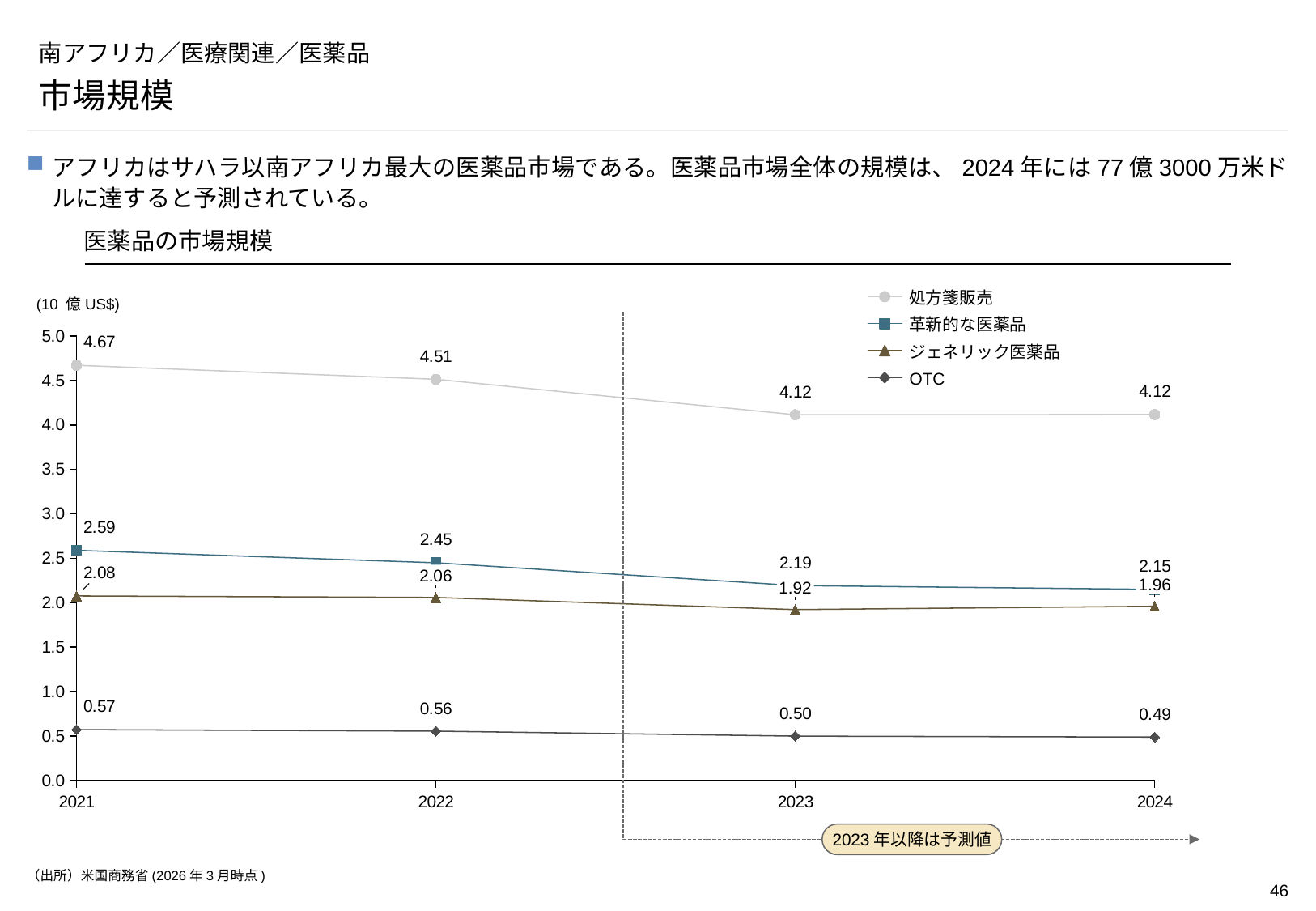
Which is larger in 2023: 革新的な医薬品 or ジェネリック医薬品? 革新的な医薬品 What is the value for 処方箋販売 in 2021? 4.67 What is the value for ジェネリック医薬品 in 2022? 2.06 How many series does the legend list? 4 Does the OTC series rise or fall from 2021 to 2024? Fall What is the value for OTC in 2024? 0.49 Which series has the highest value in 2024? 処方箋販売 What is the difference between the 処方箋販売 values for 2021 and 2024? 0.55 How many years are shown on the x axis? 4 What type of chart is shown on the slide? Line chart Which series has the lowest value in 2021? OTC What is the value for 革新的な医薬品 in 2023? 2.19